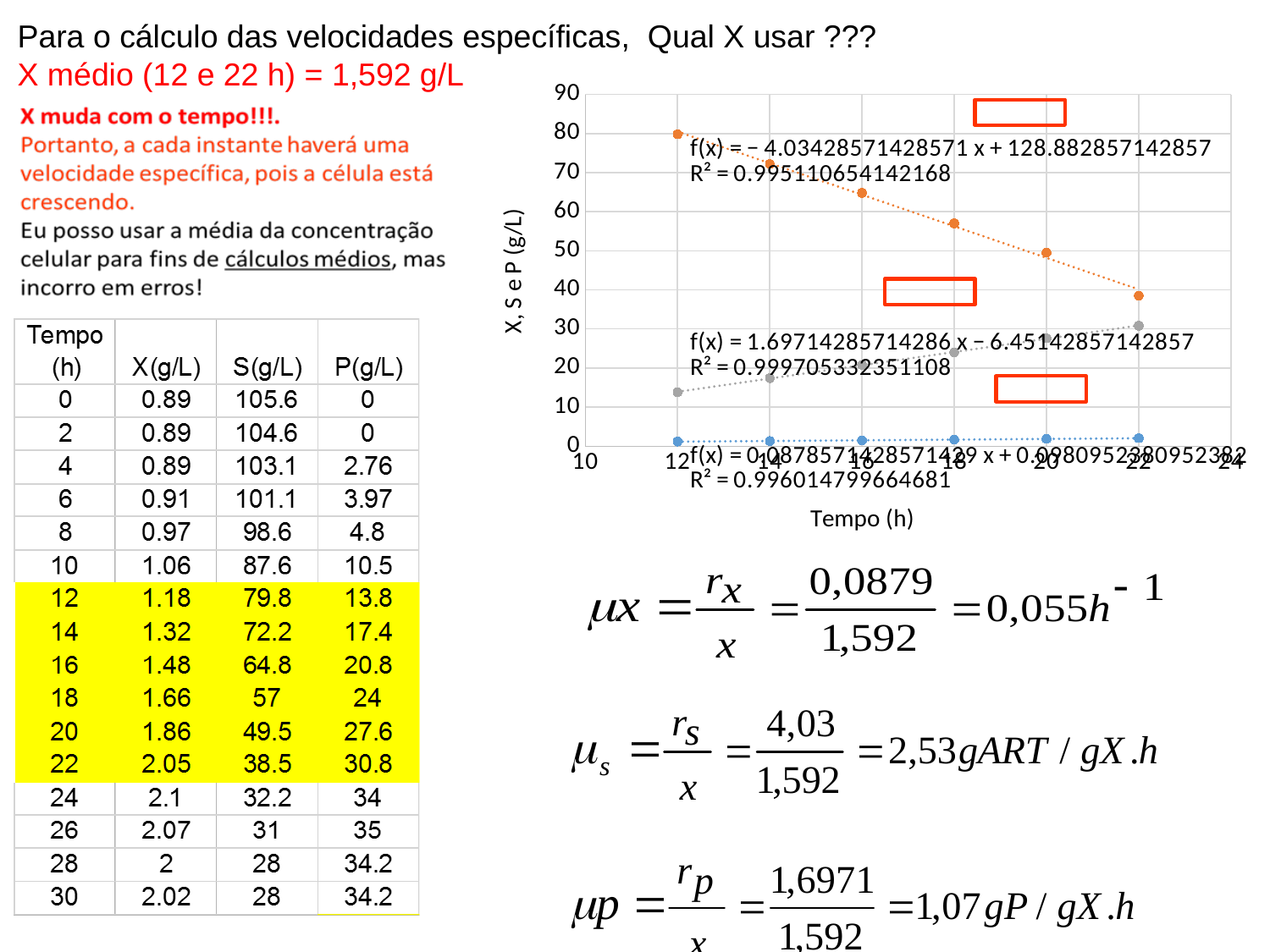
How many data points does the orange series have in the chart? 6 What kind of chart is shown on the slide? scatter chart Is the value of the orange series at 22 h greater or less than 40? less At 22 h, which series has the larger value, the orange series or the gray series? orange series What R² value is printed for the trendline of the orange series? 0.995110654142168 Is the value of the gray series at 22 h greater or less than 20? greater Do the values of the orange series rise or fall as time increases from 12 to 22 h? fall What is the title of the y axis of the chart? X, S e P (g/L) What is the title of the x axis of the chart? Tempo (h) Is the value of the orange series at 12 h greater or less than 70? greater Do the values of the gray series rise or fall as time increases from 12 to 22 h? rise